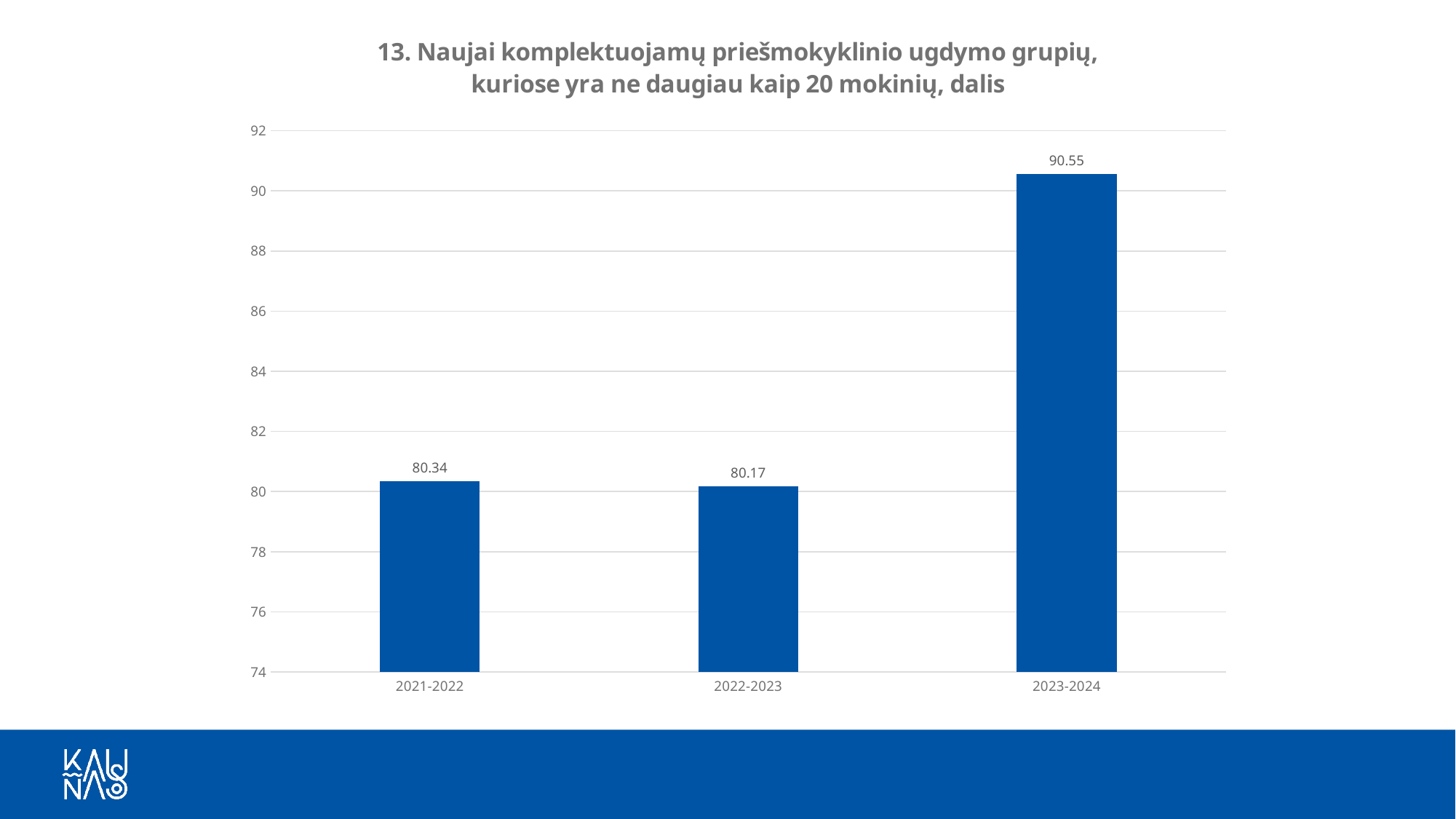
How many periods are shown on the x axis? 3 What is the difference between the values for 2023-2024 and 2021-2022? 10.21 What is the value for 2023-2024? 90.55 What is the difference between the values for 2021-2022 and 2022-2023? 0.17 What is the value for 2022-2023? 80.17 What is the value for 2021-2022? 80.34 Is the value for 2023-2024 greater or less than 90? greater Which period has the highest value? 2023-2024 What is the lowest value shown on the vertical axis? 74 What kind of chart is shown on the slide? bar chart Which period has the lowest value? 2022-2023 Which is larger, the value for 2023-2024 or the value for 2022-2023? 2023-2024